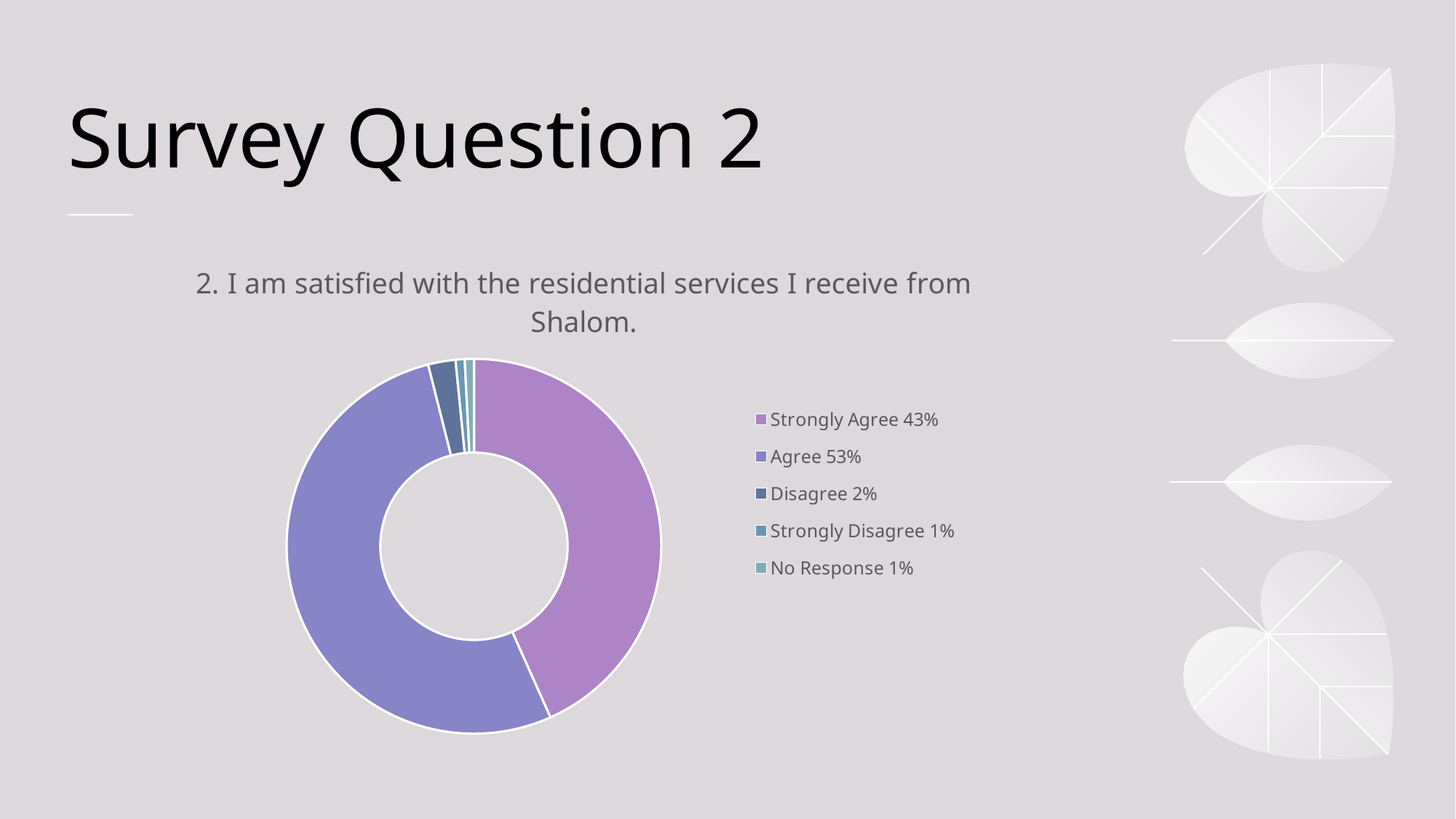
What percentage of respondents answered Strongly Disagree? 1% How many response categories does the legend list? 5 What percentage of respondents answered Agree? 53% What is the difference in percentage points between Agree and Strongly Agree? 10 What is the chart's title? 2. I am satisfied with the residential services I receive from Shalom. Which response category has the largest share? Agree What kind of chart is shown on the slide? Doughnut (pie) chart What percentage of respondents answered Disagree? 2% Which response category is shown in the pink/magenta colour? Strongly Agree Which is larger, the share for Agree or the share for Strongly Agree? Agree What percentage of respondents answered Strongly Agree? 43% What is the combined share of Strongly Agree and Agree? 96%